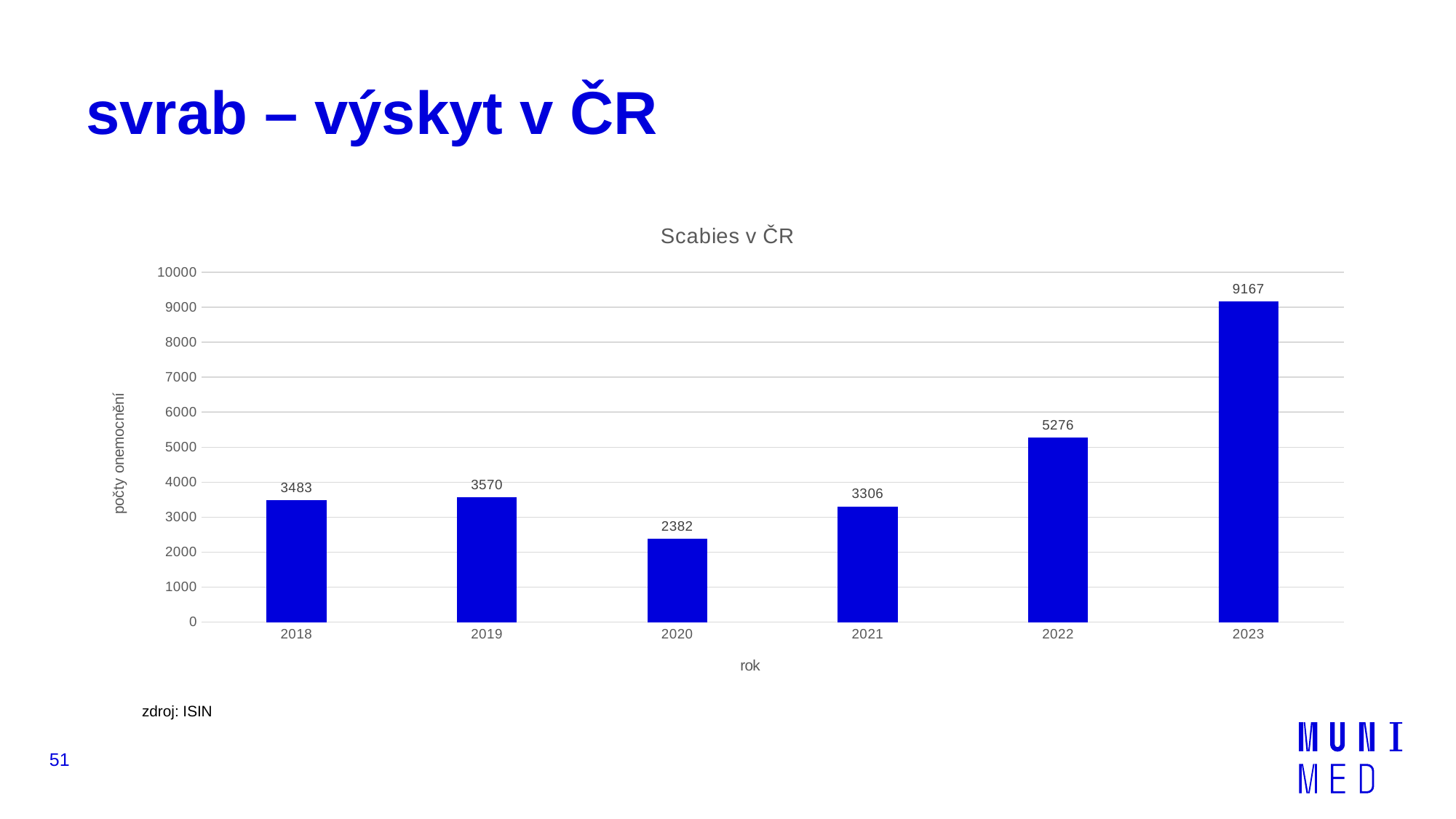
How many years are shown on the x axis of the Scabies v ČR chart? 6 Which is larger in the Scabies v ČR chart, the value for 2021 or the value for 2020? 2021 What is the value for 2018 in the Scabies v ČR chart? 3483 What is the label of the y axis in the Scabies v ČR chart? počty onemocnění Is the value for 2022 in the Scabies v ČR chart greater or less than 5000? greater Which year has the highest value in the Scabies v ČR chart? 2023 What is the value for 2020 in the Scabies v ČR chart? 2382 What is the difference between the values for 2019 and 2018 in the Scabies v ČR chart? 87 What is the difference between the values for 2023 and 2022 in the Scabies v ČR chart? 3891 What is the value for 2022 in the Scabies v ČR chart? 5276 What kind of chart is the Scabies v ČR chart? bar chart Which year has the lowest value in the Scabies v ČR chart? 2020